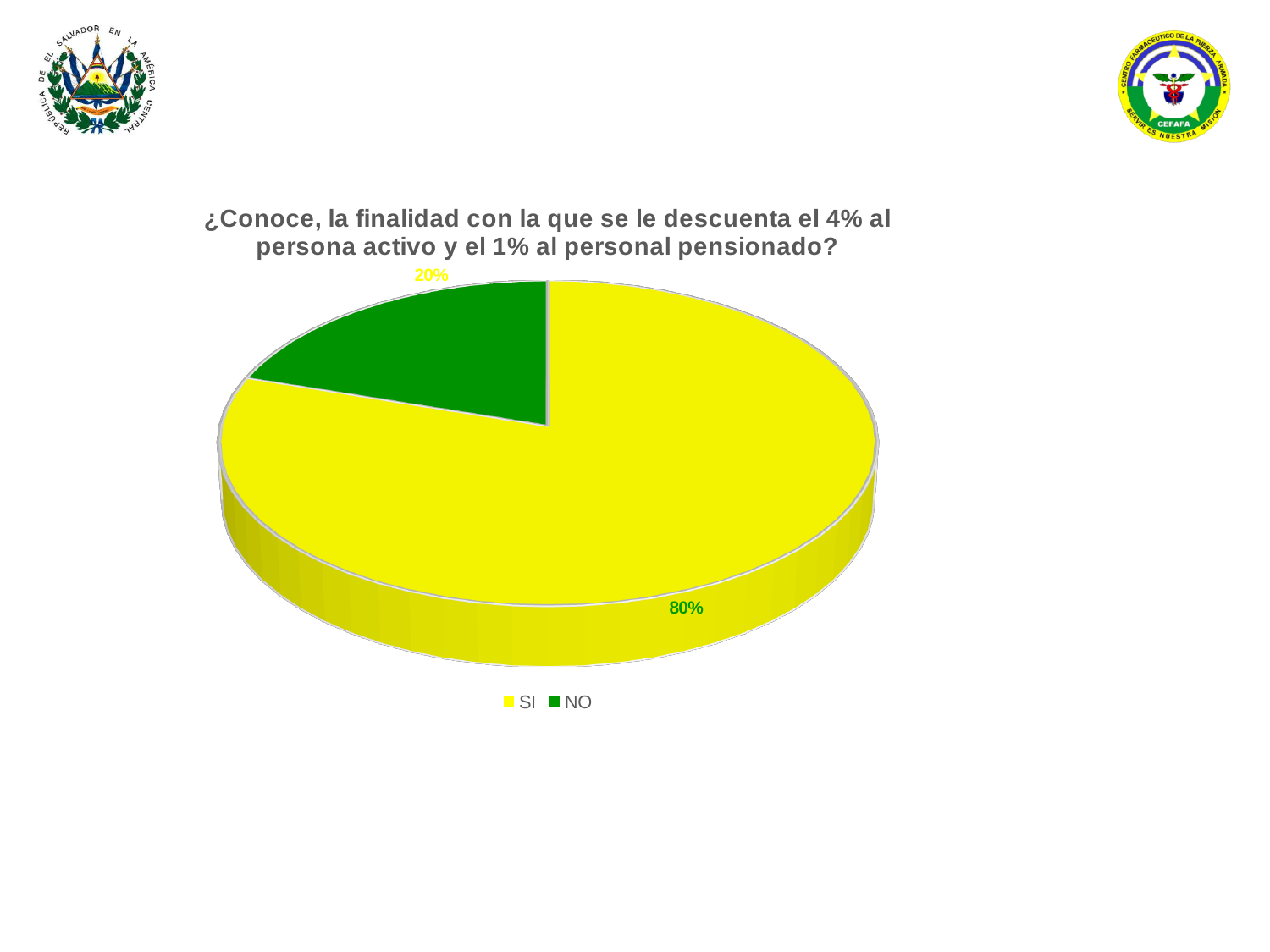
Which category has the smallest slice of the pie? NO What percentage of respondents answered SI? 80% What percentage of respondents answered NO? 20% How many entries does the legend list? 2 What colour is the NO slice? green What colour is the SI slice? yellow Which is larger, the SI slice or the NO slice? SI What kind of chart is shown on the slide? pie chart Which category has the largest slice of the pie? SI What share of the pie does the SI slice represent? 80% How many categories does the pie chart show? 2 What is the difference in percentage points between the SI and NO slices? 60